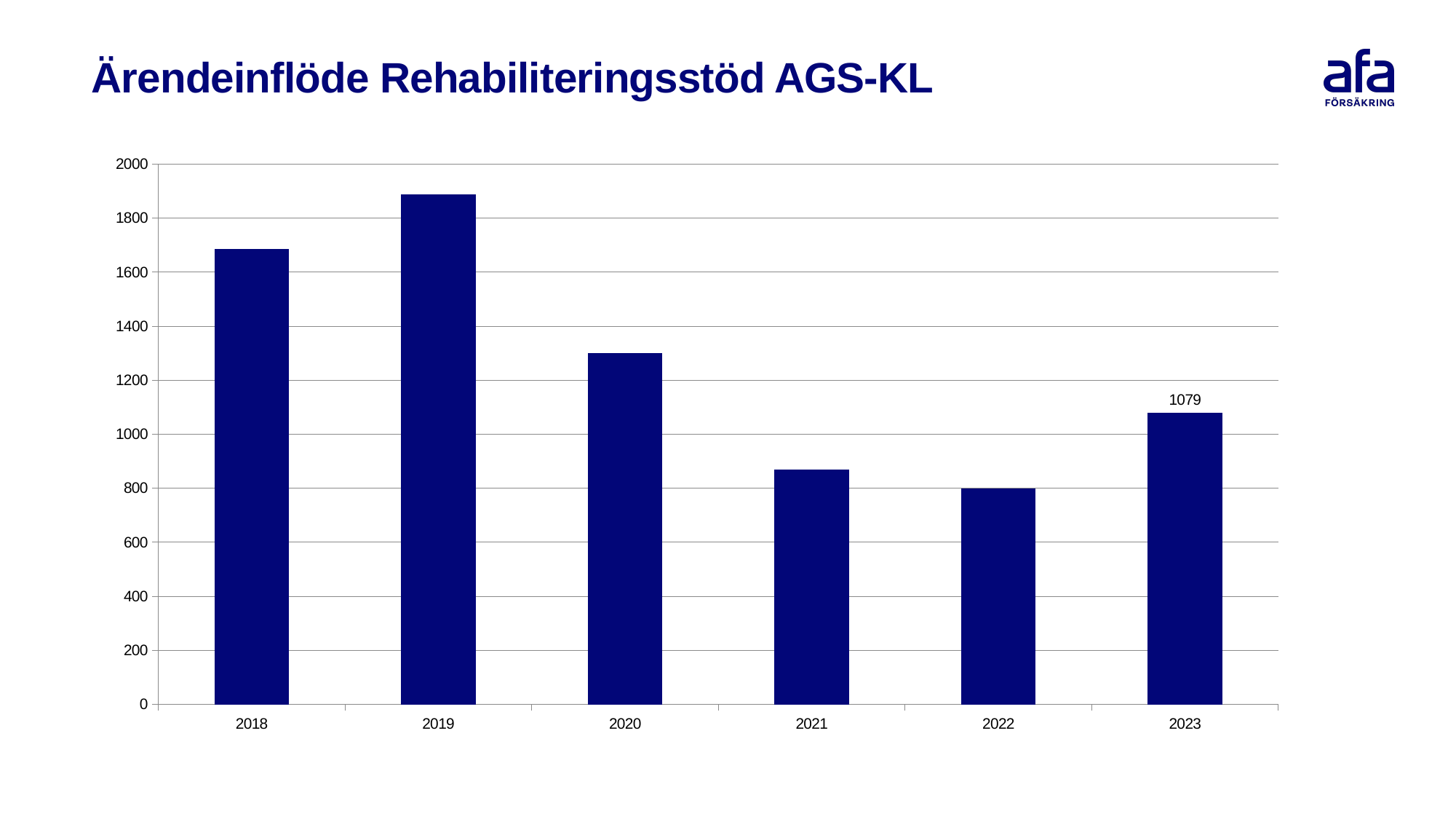
What kind of chart is shown on the slide? bar chart Which year has the lowest value? 2022 What is the value for 2023? 1079 Is the value for 2020 greater or less than 1400? less Is the value for 2018 greater or less than 1600? greater Is the value for 2021 greater or less than 1000? less Which year has the highest value? 2019 Do the values rise or fall from 2019 to 2022? fall Which is larger, the value for 2018 or the value for 2019? 2019 How many years are shown on the x axis? 6 Which is larger, the value for 2020 or the value for 2023? 2020